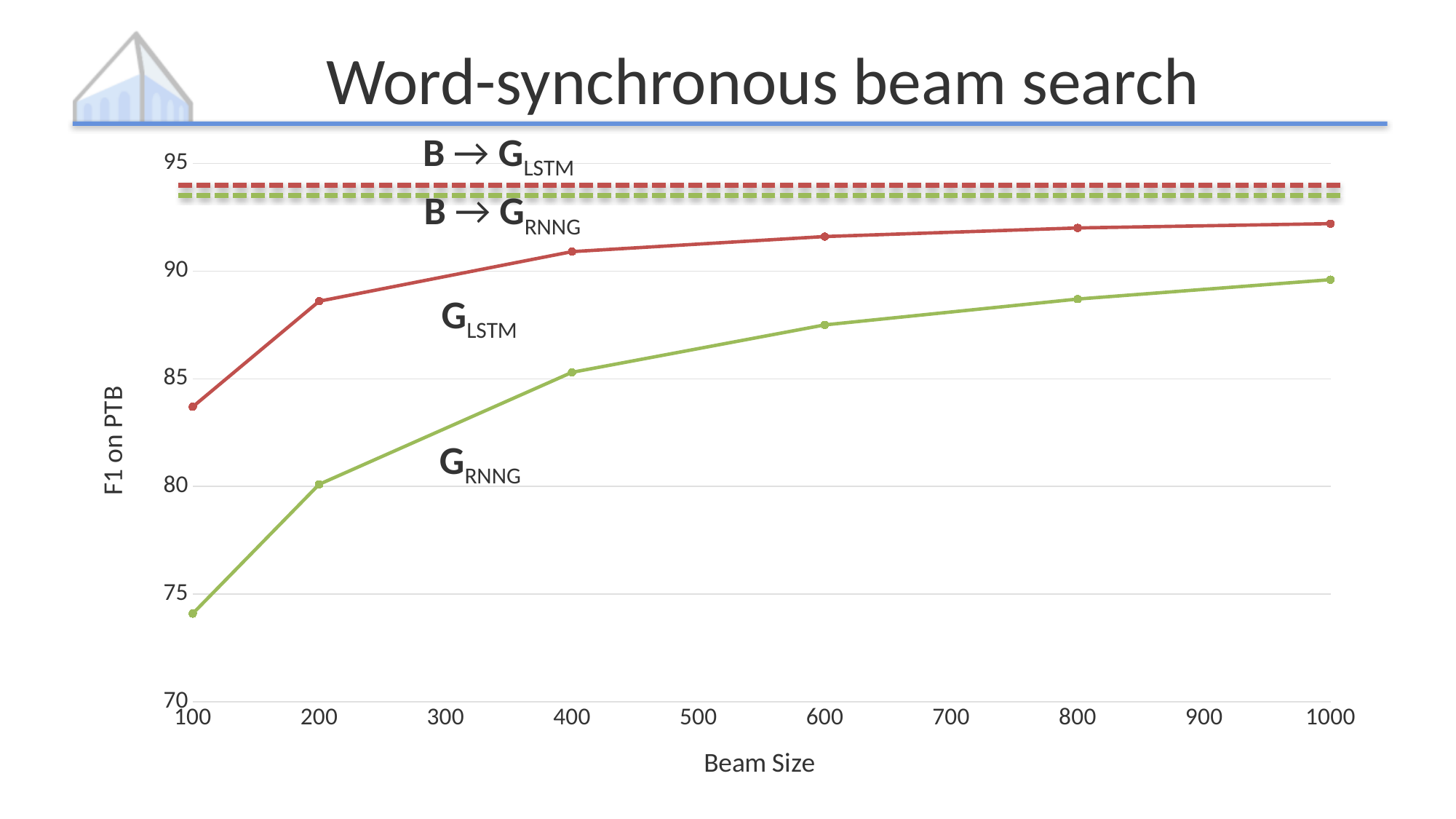
Is the F1 value for G_LSTM at beam size 100 greater or less than 85? less What kind of chart is shown on the slide? line chart At which beam size does G_RNNG reach its lowest F1? 100 Does the F1 of G_RNNG rise or fall as beam size increases? rise Is the F1 value for G_LSTM at beam size 200 greater or less than 85? greater Which line has the higher F1 at beam size 400, G_LSTM or G_RNNG? G_LSTM Is the F1 value for G_RNNG at beam size 100 greater or less than 75? less What is the title of the slide containing the chart? Word-synchronous beam search What is the label of the y axis? F1 on PTB How many data points are plotted on the G_LSTM line? 6